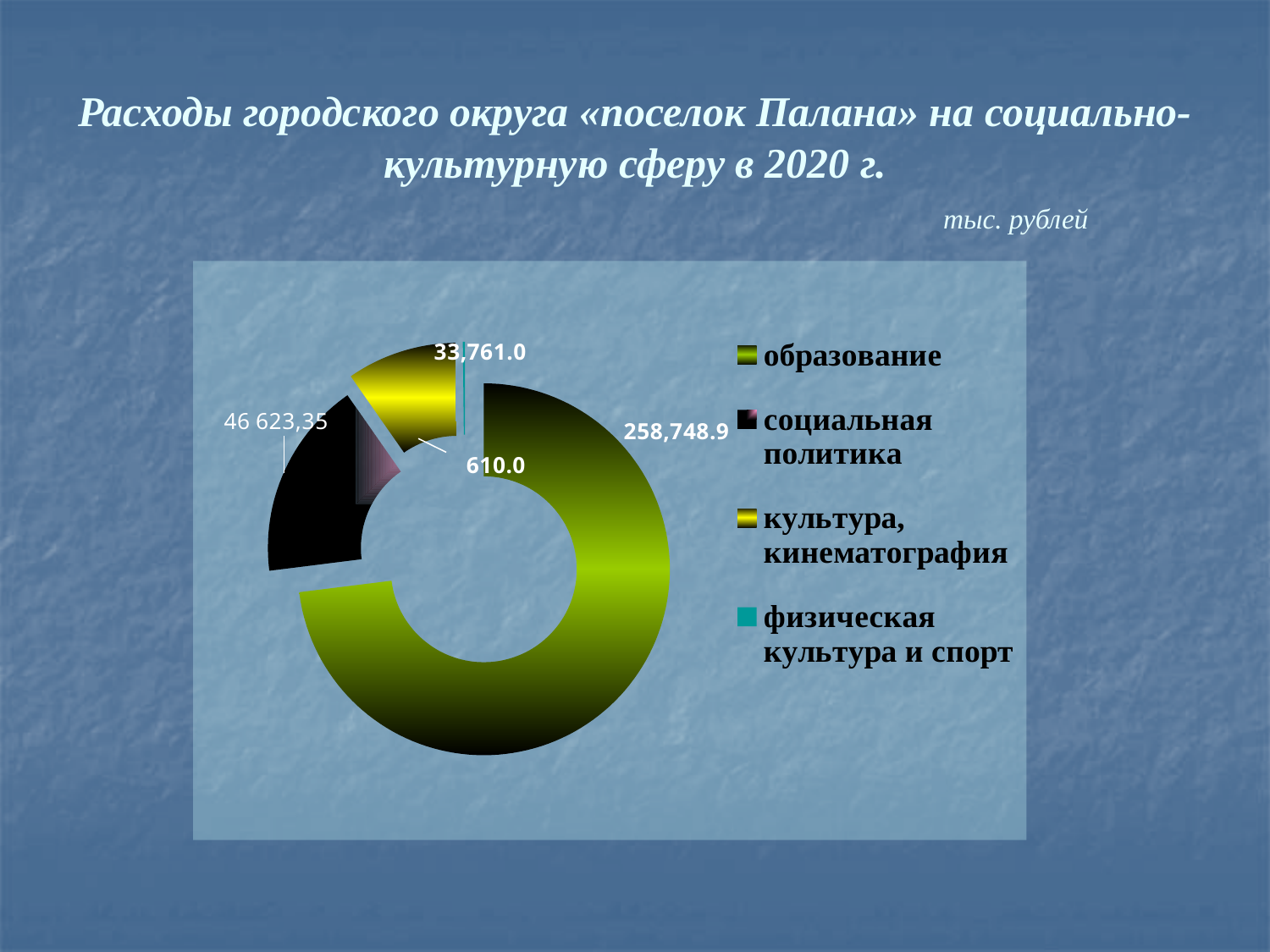
What kind of chart is shown on the slide? doughnut chart How many categories does the chart show? 4 What is the difference between культура, кинематография and физическая культура и спорт? 33,151.0 What is the value for социальная политика? 46 623,35 Which is larger, социальная политика or культура, кинематография? социальная политика What is the value for культура, кинематография? 33,761.0 Which category has the highest value? образование Which legend entry is shown in black? социальная политика In what units are the values on the chart given? тыс. рублей What is the value for образование? 258,748.9 Which category has the lowest value? физическая культура и спорт What is the value for физическая культура и спорт? 610.0